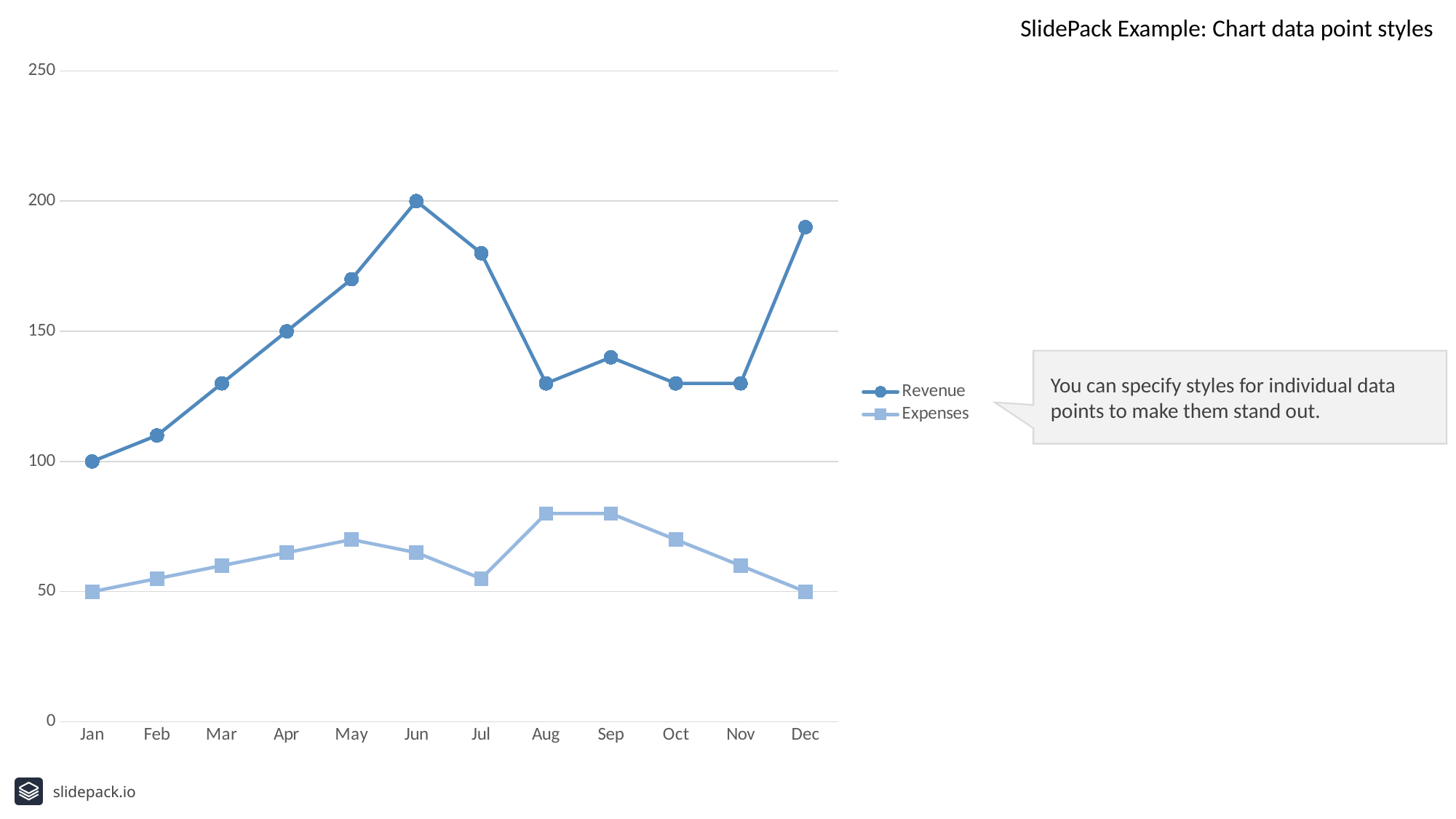
What type of chart is shown on the slide? Line chart Is the Expenses value for Aug greater or less than 100? less Does Revenue rise or fall from Jan to Jun? Rise What is the difference between Revenue in Jun and Revenue in Jan? 100 What is the Revenue value for Jun? 200 What is the Expenses value for Jan? 50 In which month is Revenue highest? Jun How many months are plotted along the x axis? 12 How many series does the legend list? 2 In which month is Revenue lowest? Jan What is the Revenue value for Jan? 100 Is the Revenue value for Dec greater or less than 150? greater